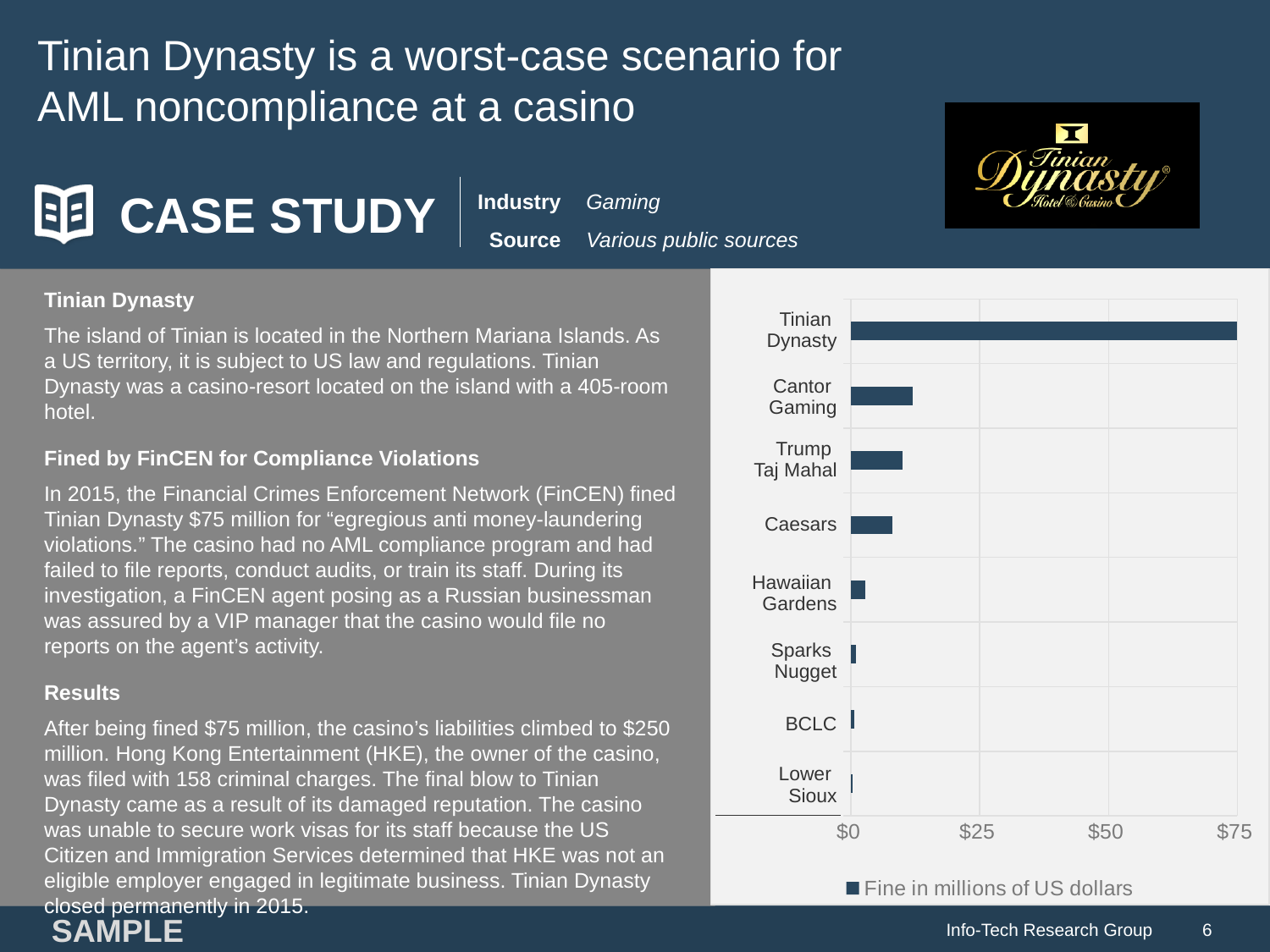
Which casino has the largest fine in the chart? Tinian Dynasty How many casinos are listed as categories in the chart? 8 Is the fine for Caesars greater or less than $25 million? less Which has the larger fine, Hawaiian Gardens or Sparks Nugget? Hawaiian Gardens What is the series name shown in the chart legend? Fine in millions of US dollars Is the fine for Tinian Dynasty greater or less than $50 million? greater What is the fine in millions of US dollars for Tinian Dynasty? $75 What kind of chart is shown on the slide? Bar chart Is the fine for Cantor Gaming greater or less than $25 million? less How many series does the chart legend list? 1 Which has the larger fine, Cantor Gaming or Caesars? Cantor Gaming Which casino has the smallest fine in the chart? Lower Sioux